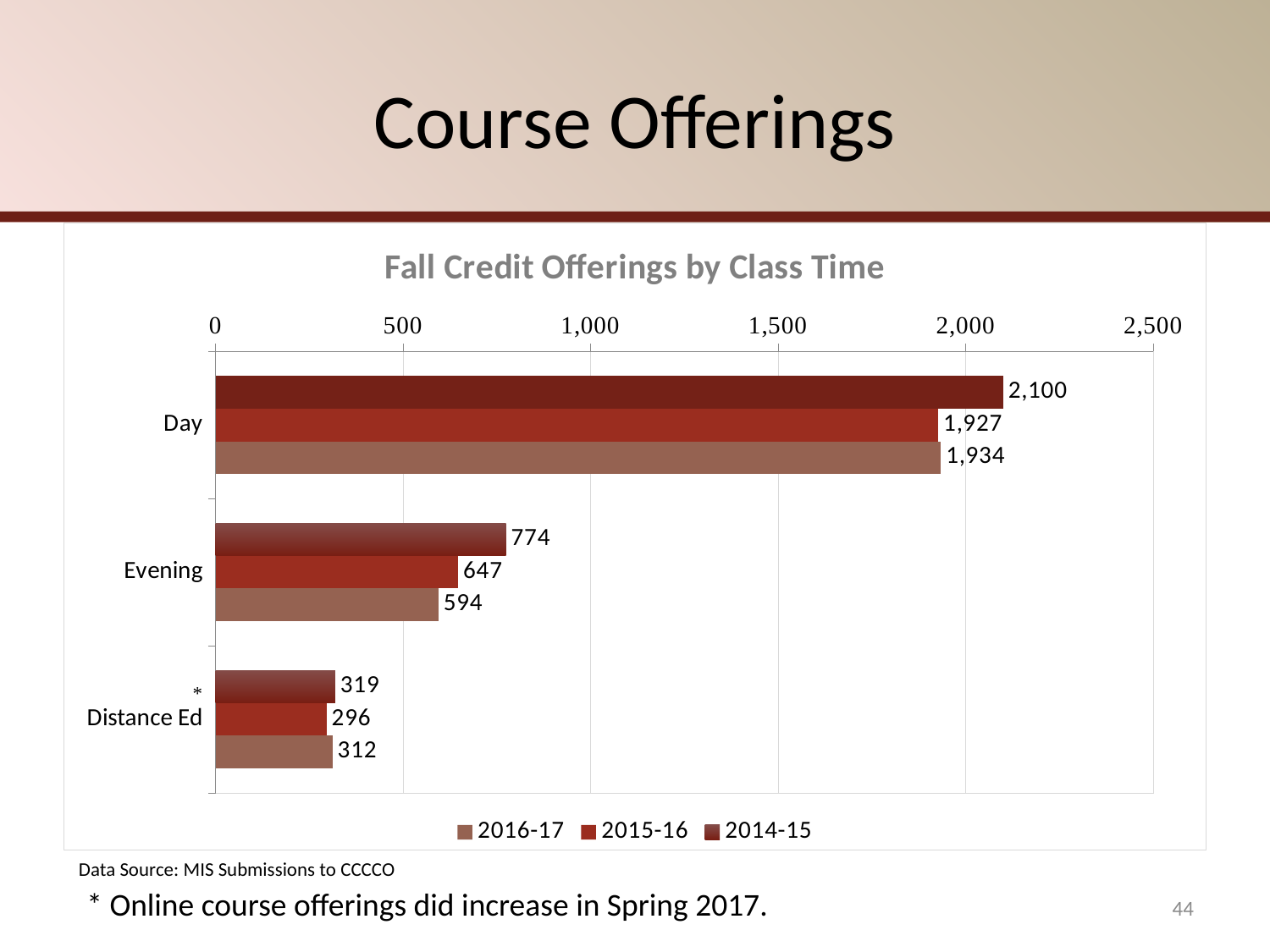
Which is larger for Distance Ed: the 2016-17 value or the 2015-16 value? 2016-17 What is the value for Evening in the 2016-17 series? 594 How many series does the legend list? 3 What is the value for Day in the 2016-17 series? 1,934 What is the value for Distance Ed in the 2015-16 series? 296 Which class time has the lowest value in the 2016-17 series? Distance Ed Is the 2015-16 value for Day greater or less than 2,000? less What type of chart is shown on the slide? Bar chart What is the difference between the 2014-15 and 2016-17 values for Evening? 180 How many class time categories are shown on the chart? 3 Which class time has the highest value in the 2014-15 series? Day What is the value for Day in the 2014-15 series? 2,100